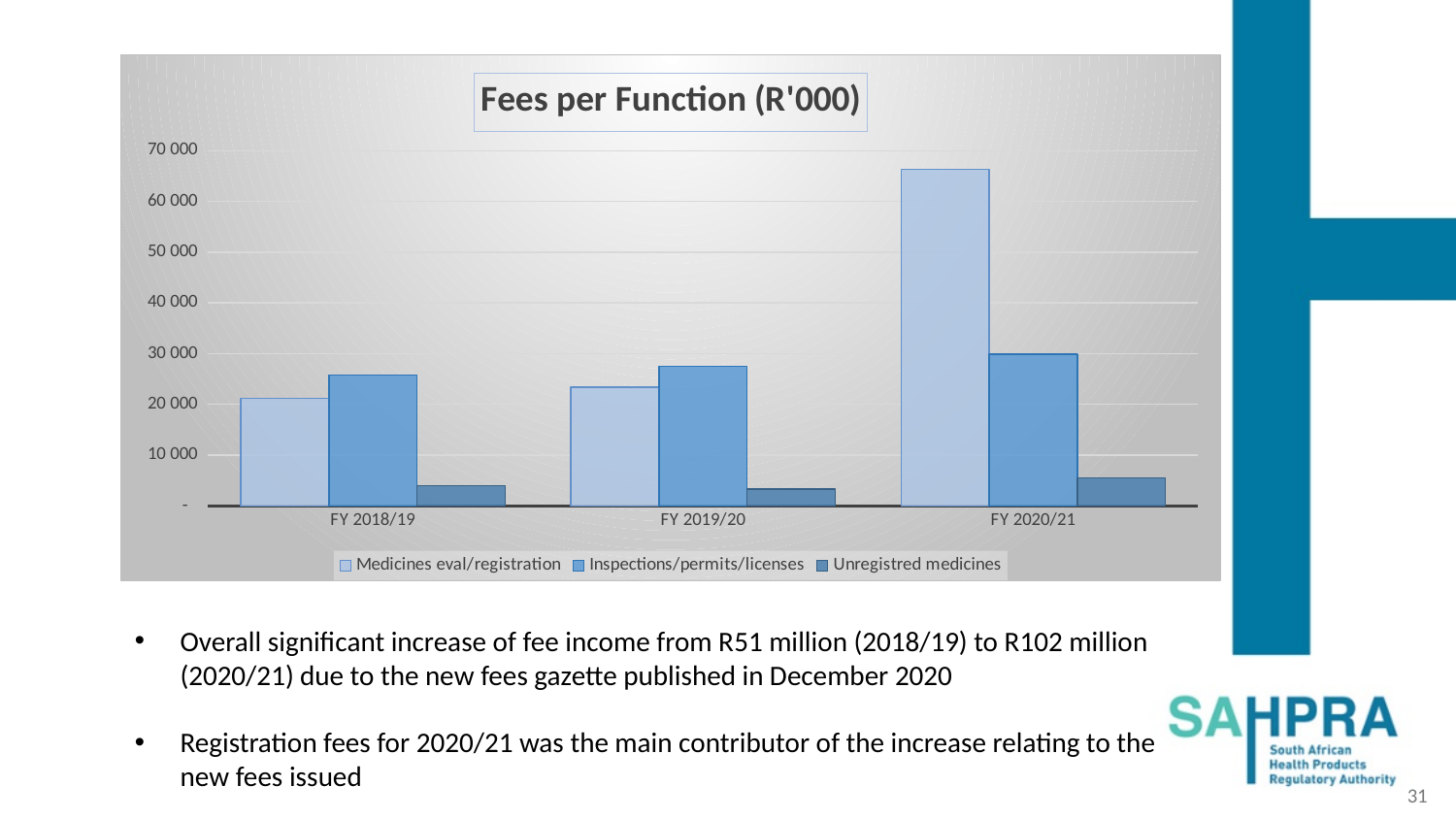
How many series does the chart legend list? 3 Is the value for Medicines eval/registration in FY 2020/21 greater or less than 60 000? greater In which financial year is the Medicines eval/registration bar the highest? FY 2020/21 What is the title of the chart? Fees per Function (R'000) Is the value for Unregistred medicines in FY 2018/19 greater or less than 10 000? less How many financial years are shown on the x axis of the chart? 3 Do the Medicines eval/registration values rise or fall from FY 2018/19 to FY 2020/21? rise Which series has the tallest bar in the chart? Medicines eval/registration What kind of chart is shown on the slide? bar chart In FY 2020/21, which is larger: Medicines eval/registration or Inspections/permits/licenses? Medicines eval/registration Is the value for Inspections/permits/licenses in FY 2020/21 greater or less than 40 000? less In FY 2018/19, which is larger: Medicines eval/registration or Inspections/permits/licenses? Inspections/permits/licenses